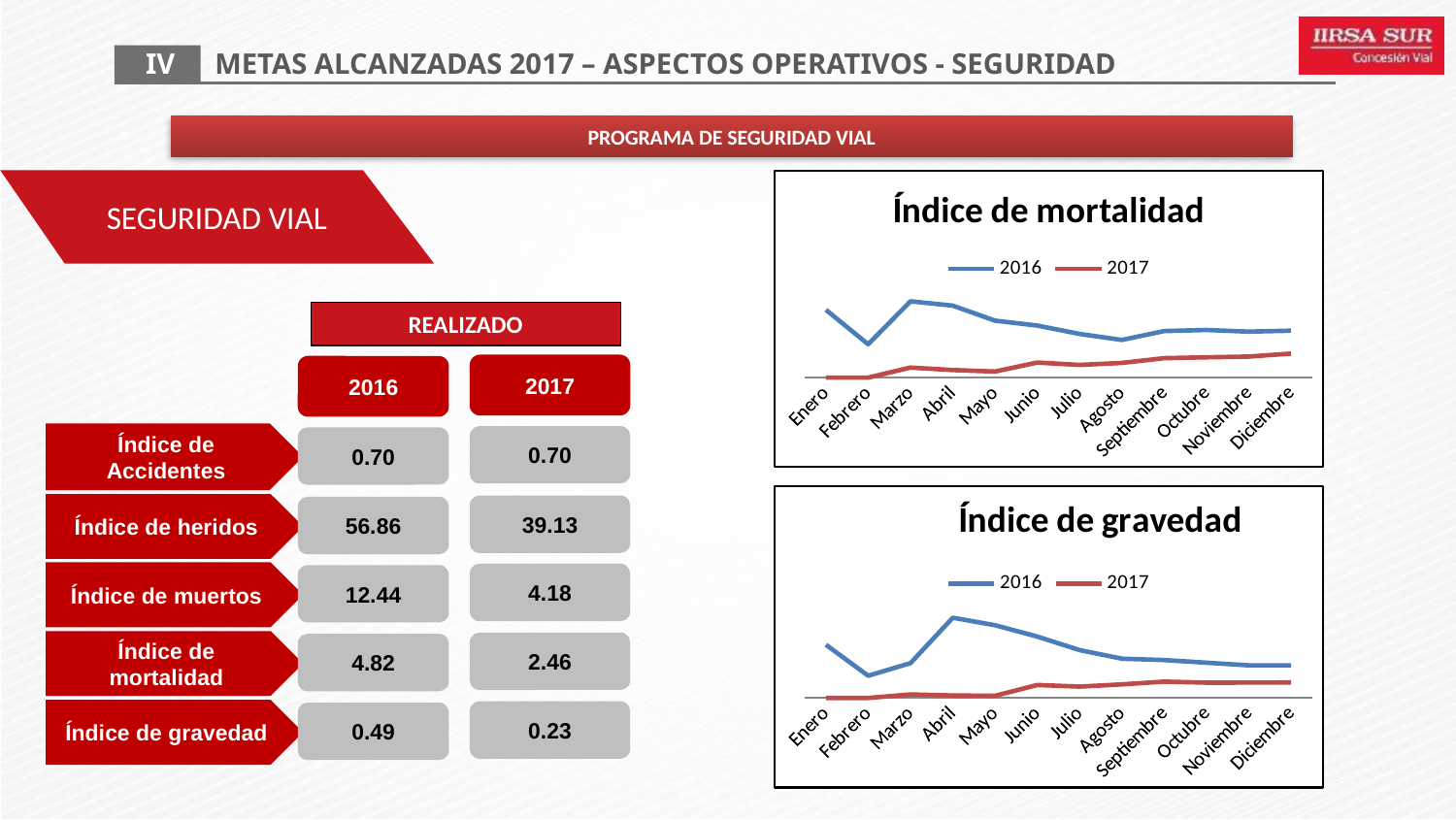
In the 'Índice de gravedad' chart, does the 2016 series rise or fall from Abril to Diciembre? fall In the 'Índice de mortalidad' chart, how many series does the legend list? 2 In the 'Índice de gravedad' chart, which month has the highest value for the 2016 series? Abril In the 'Índice de gravedad' chart, which month has the lowest value for the 2016 series? Febrero In the 'Índice de mortalidad' chart, which series has the larger value in Marzo, 2016 or 2017? 2016 What kind of chart is the 'Índice de gravedad' chart? line chart In the 'Índice de mortalidad' chart, which month has the lowest value for the 2016 series? Febrero In the 'Índice de mortalidad' chart, how many months are plotted along the x axis? 12 In the 'Índice de mortalidad' chart, does the 2017 series generally rise or fall from Enero to Diciembre? rise In the 'Índice de mortalidad' chart, which colour is used for the 2017 series? red In the 'Índice de gravedad' chart, what are the two entries listed in the legend? 2016 and 2017 What kind of chart is the 'Índice de mortalidad' chart? line chart